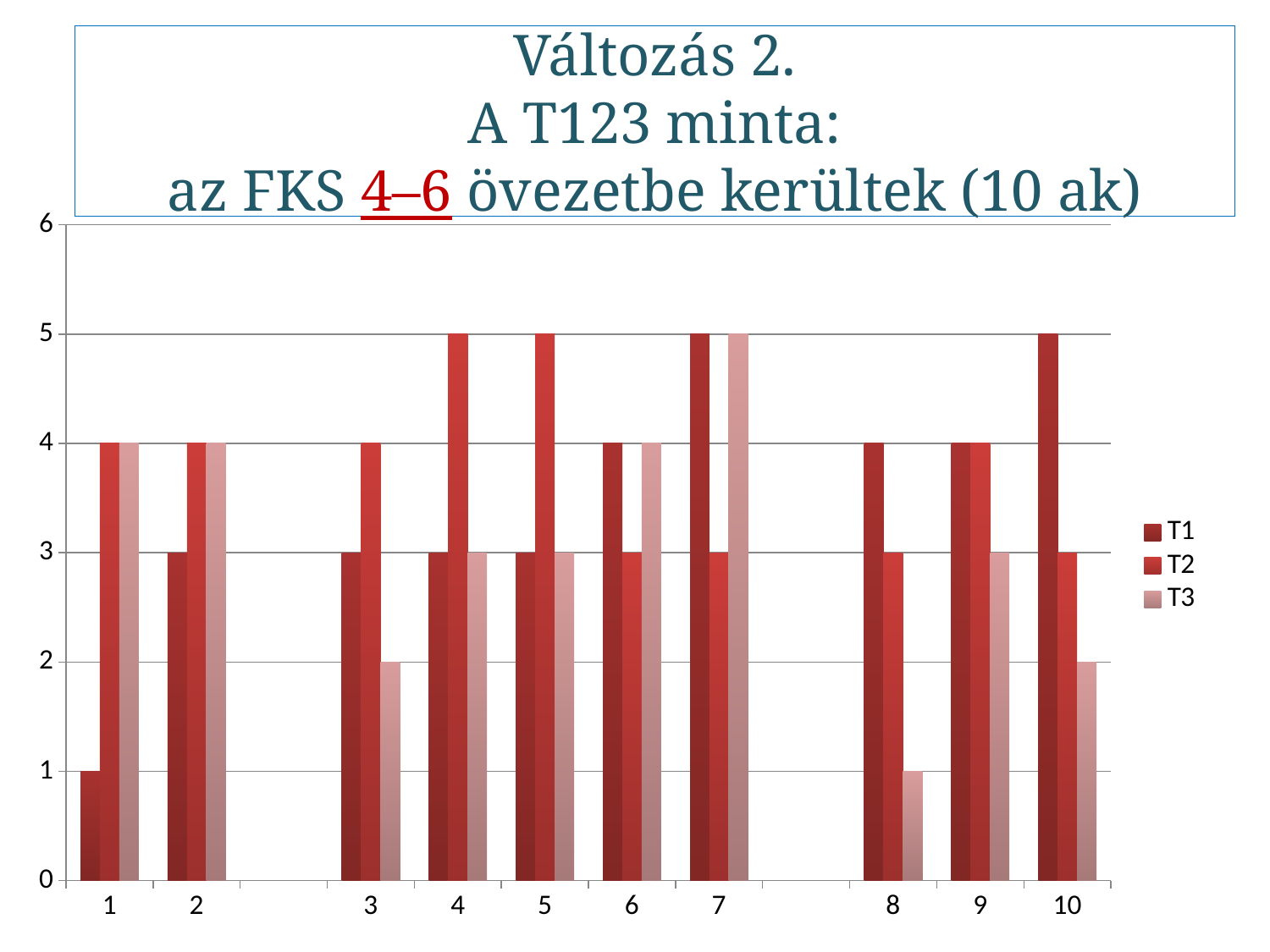
What is the T3 value for category 8? 1 What is the T1 value for category 10? 5 What kind of chart is shown on the slide? bar chart How many series does the legend list? 3 What is the T1 value for category 1? 1 What are the names of the three series in the legend? T1, T2, T3 What is the difference between the T2 and T3 values for category 8? 2 How many categories are shown on the x axis? 10 Which category has the lowest T1 value? 1 Is the T3 value for category 7 greater or less than 4? greater Which is larger for category 3, the T2 value or the T3 value? T2 What is the T2 value for category 4? 5